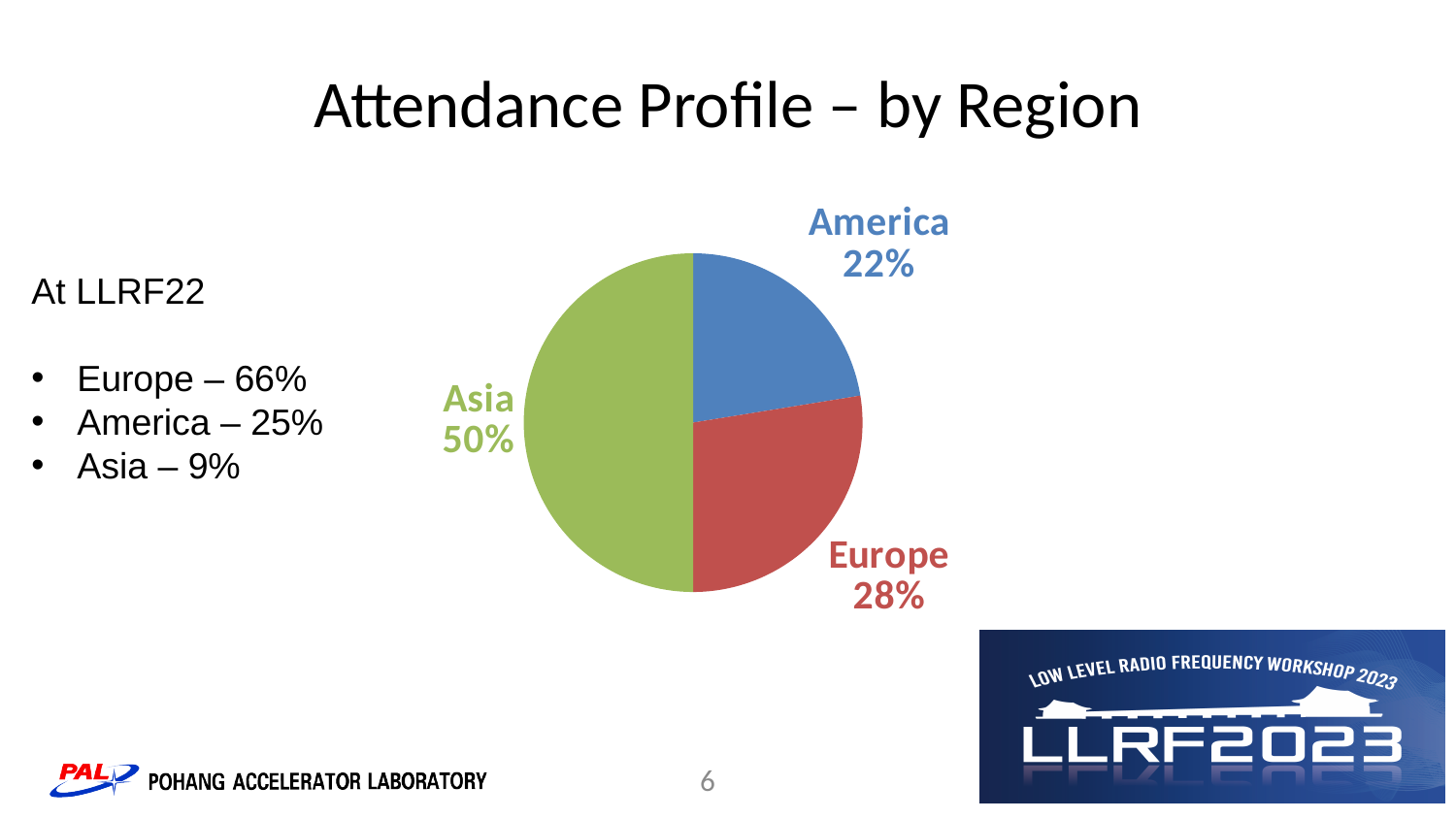
What colour is the Asia slice of the pie? green What share of the pie does Europe have? 28% What share of the pie does America have? 22% What is the difference in percentage points between the Europe slice and the America slice? 6 Which slice is larger, Europe or America? Europe What is the title of the slide containing the pie chart? Attendance Profile – by Region Which region has the smallest slice of the pie? America What is the difference in percentage points between the Asia slice and the Europe slice? 22 How many slices does the pie chart have? 3 What kind of chart is shown on the slide? pie chart Which region has the largest slice of the pie? Asia What share of the pie does Asia have? 50%